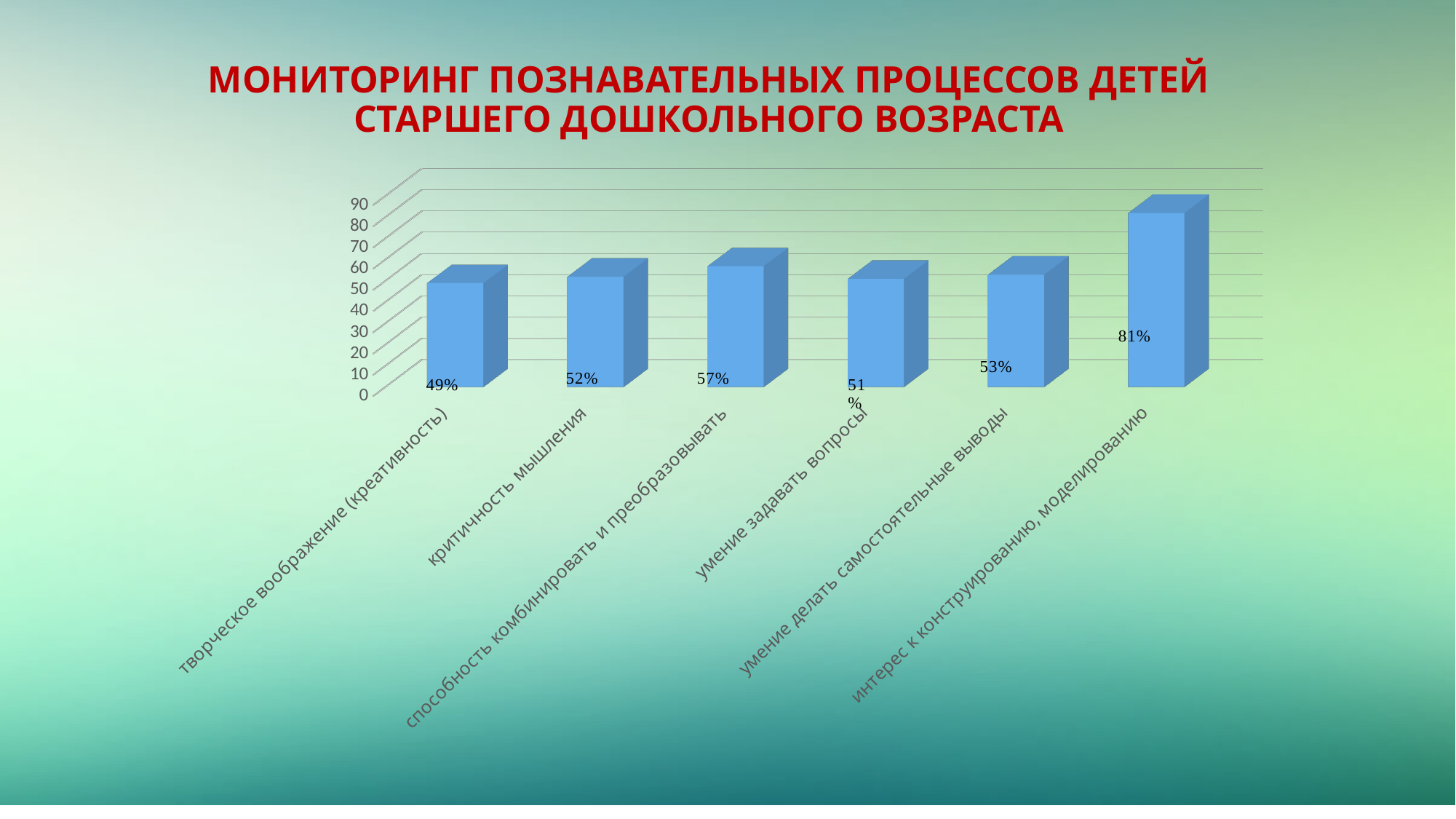
How many categories are shown in the chart? 6 What is the title of the slide? МОНИТОРИНГ ПОЗНАВАТЕЛЬНЫХ ПРОЦЕССОВ ДЕТЕЙ СТАРШЕГО ДОШКОЛЬНОГО ВОЗРАСТА What is the difference between the values for "способность комбинировать и преобразовывать" and "критичность мышления"? 5% What is the value for "творческое воображение (креативность)"? 49% Which category has the highest value? интерес к конструированию, моделированию Which category has the lowest value? творческое воображение (креативность) What is the difference between the values for "интерес к конструированию, моделированию" and "творческое воображение (креативность)"? 32% What kind of chart is shown on the slide? bar chart What is the value for "интерес к конструированию, моделированию"? 81% Which is larger, the value for "умение задавать вопросы" or the value for "умение делать самостоятельные выводы"? умение делать самостоятельные выводы What is the value for "умение делать самостоятельные выводы"? 53% What is the value for "способность комбинировать и преобразовывать"? 57%